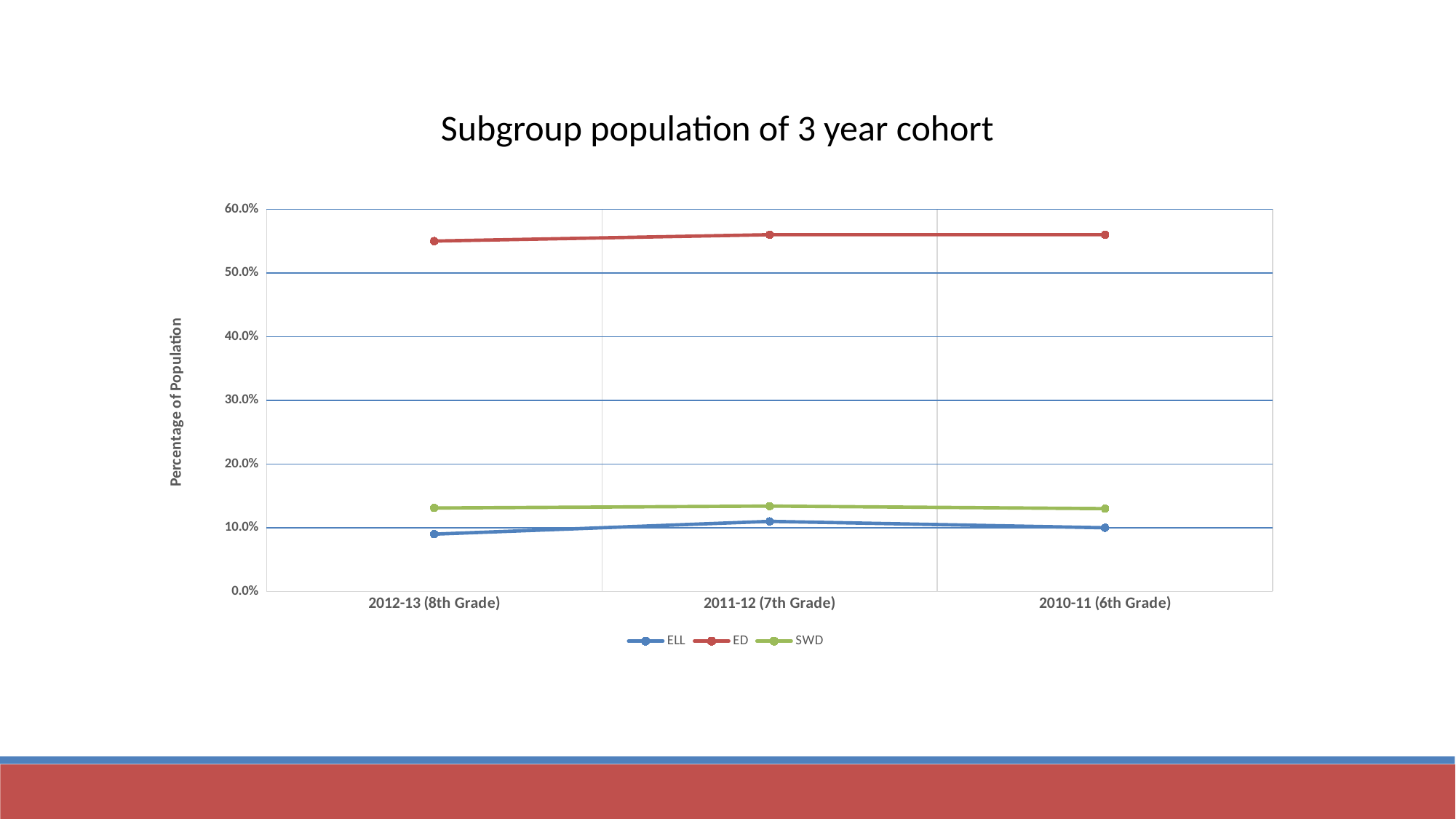
Which is larger at 2010-11 (6th Grade), the value for ED or the value for SWD? ED Is the value for ELL at 2012-13 (8th Grade) greater or less than 10.0%? less Is the value for SWD at 2011-12 (7th Grade) greater or less than 10.0%? greater Which series has the highest values across all three years? ED Which series has the lowest value at 2012-13 (8th Grade)? ELL What is the label on the y axis? Percentage of Population How many categories are shown on the x axis? 3 Is the value for ED at 2012-13 (8th Grade) greater or less than 50.0%? greater What is the title of the chart? Subgroup population of 3 year cohort How many series does the legend list? 3 What kind of chart is shown on the slide? line chart